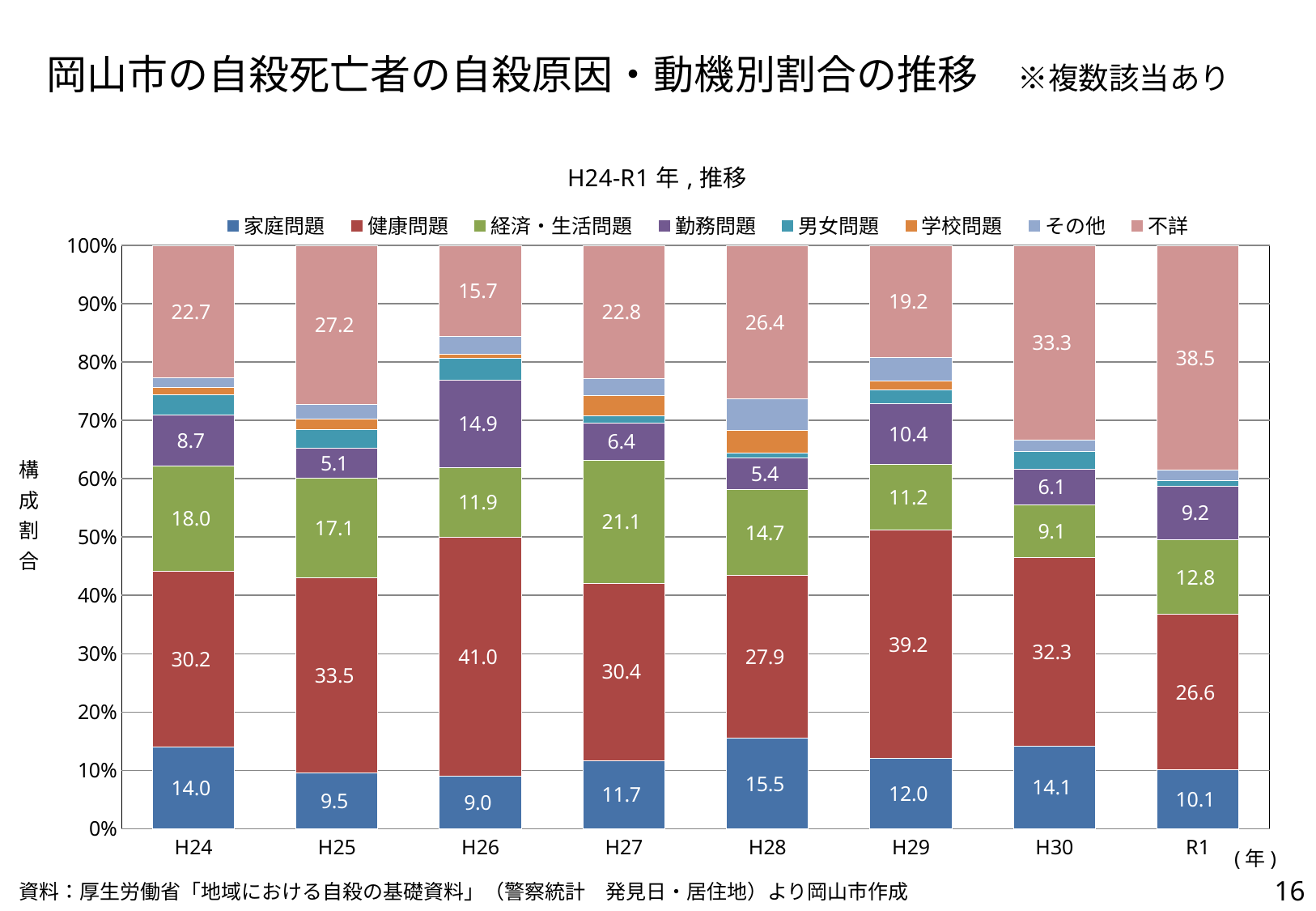
How many series does the legend list? 8 What kind of chart is this? Stacked bar chart Does the value for 不詳 rise or fall from H29 to R1? Rise What is the value for 不詳 in R1? 38.5 In which year is the value for 健康問題 the highest? H26 What is the difference between the 不詳 values for R1 and H24? 15.8 In which year is the value for 家庭問題 the lowest? H26 How many years are shown on the x axis? 8 Which is larger, the 経済・生活問題 value in H24 or in H30? H24 What is the value for 経済・生活問題 in H27? 21.1 What is the value for 健康問題 in H26? 41.0 What is the value for 勤務問題 in H29? 10.4